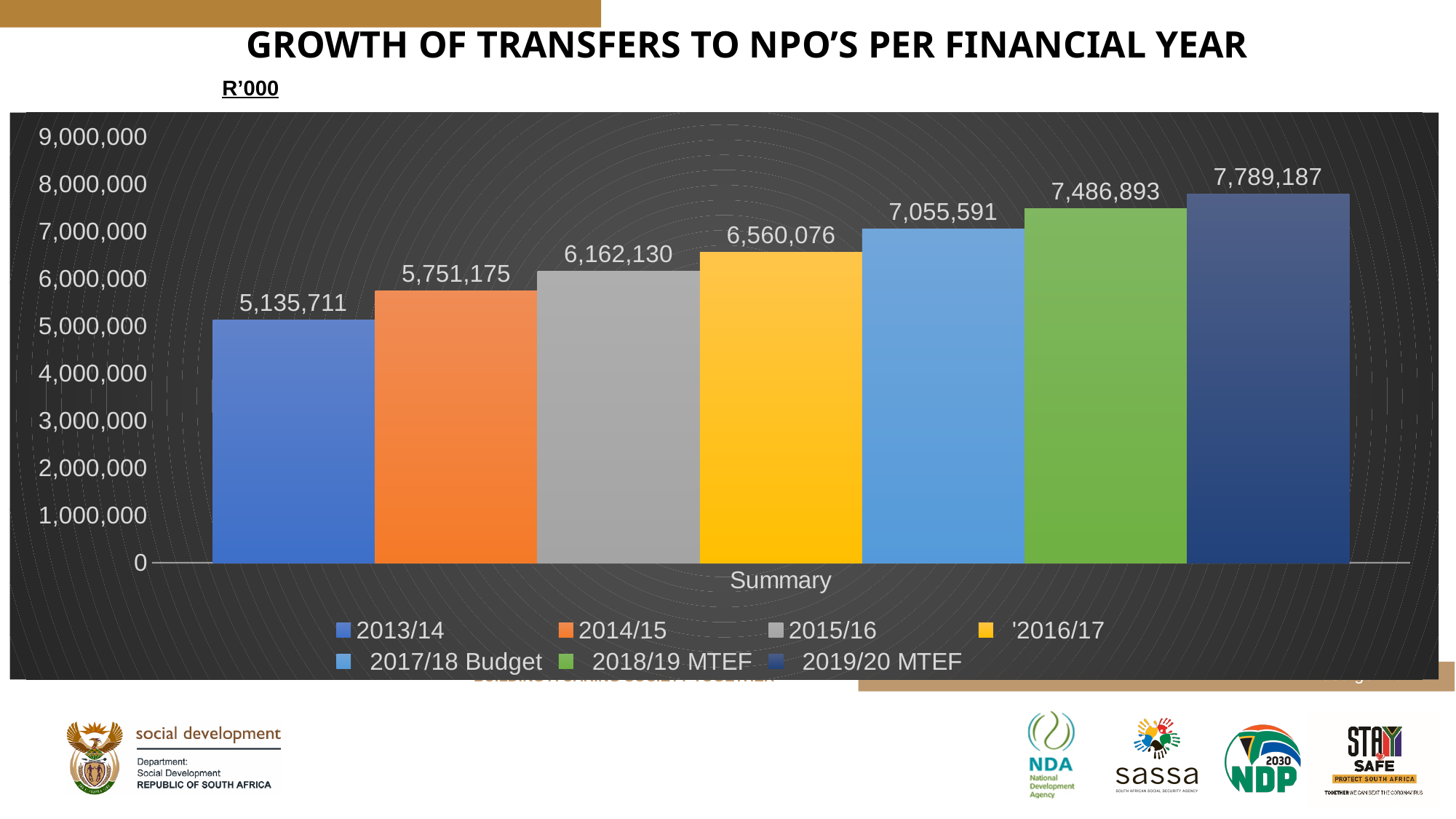
Which financial year has the lowest value of transfers? 2013/14 What kind of chart is shown on the slide? Bar chart What is the difference between the 2019/20 MTEF value and the 2013/14 value? 2,653,476 Do the transfer values rise or fall from 2013/14 to 2019/20 MTEF? Rise What is the difference between the 2018/19 MTEF value and the 2017/18 Budget value? 431,302 Which is larger, the value for 2014/15 or the value for 2016/17? 2016/17 Which financial year has the highest value of transfers? 2019/20 MTEF How many series does the legend list? 7 What is the value shown for 2019/20 MTEF? 7,789,187 What is the value shown for 2017/18 Budget? 7,055,591 What is the value of transfers to NPOs for 2013/14? 5,135,711 What is the value shown for 2015/16? 6,162,130